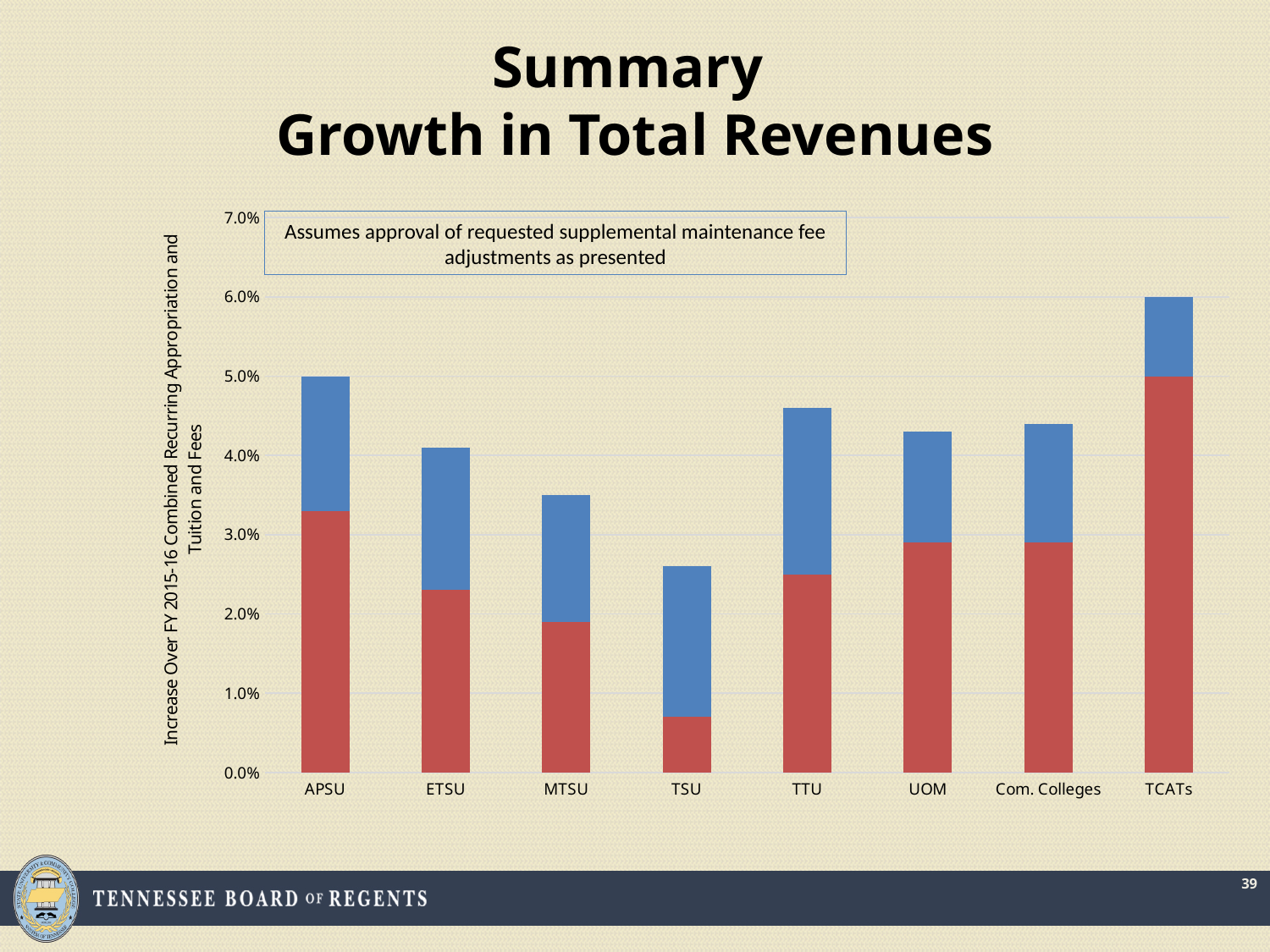
What assumption is stated in the text box on the chart? Assumes approval of requested supplemental maintenance fee adjustments as presented Which category has the highest total bar? TCATs What is the total bar height for TCATs? 6.0% How many institutions or groups are shown along the x axis? 8 Which category has the lowest total bar? TSU Which has a larger total bar, ETSU or TSU? ETSU What is the title of the slide? Summary Growth in Total Revenues Is the total value for TTU greater or less than 4.0%? greater Is the total value for MTSU greater or less than 4.0%? less What is the total bar height for APSU? 5.0% Is the total value for TSU greater or less than 3.0%? less What kind of chart is shown on the slide? stacked bar chart